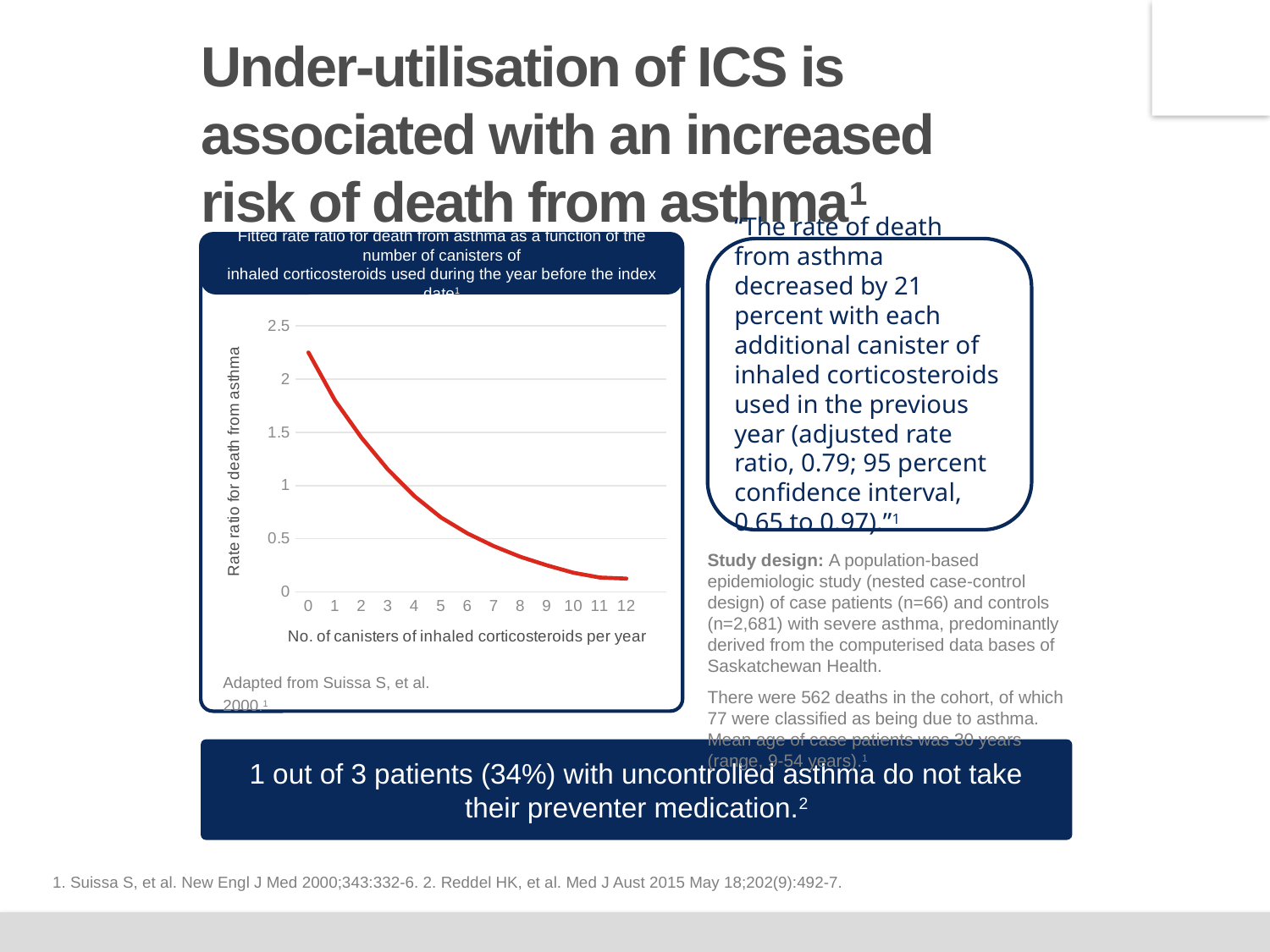
How many tick marks are shown on the x axis? 13 What kind of chart is shown on the slide? line chart At which number of canisters per year is the rate ratio for death from asthma highest? 0 Is the rate ratio at 6 canisters per year greater or less than 1? less What is the label of the x axis? No. of canisters of inhaled corticosteroids per year Is the rate ratio at 1 canister per year greater or less than 1.5? greater Which has the higher rate ratio for death from asthma: 0 canisters per year or 12 canisters per year? 0 canisters per year Is the rate ratio at 3 canisters per year greater or less than 1.5? less What is the label of the y axis? Rate ratio for death from asthma Does the rate ratio for death from asthma rise or fall as the number of canisters per year increases? fall